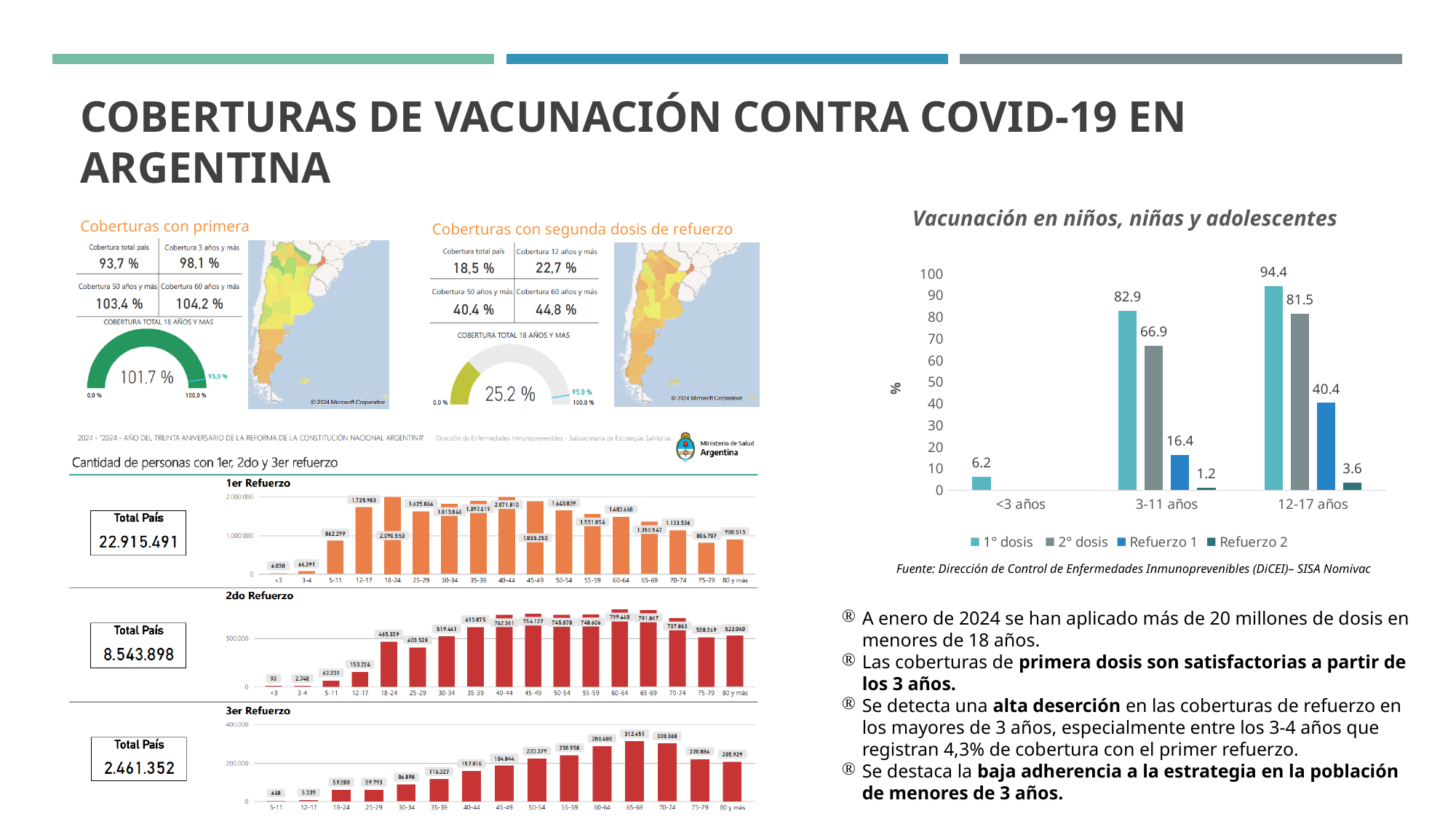
In the 'Vacunación en niños, niñas y adolescentes' chart, which age group has the highest 1° dosis value? 12-17 años In the '3er Refuerzo' chart on the left, what is the Total País value shown? 2.461.352 In the 'Vacunación en niños, niñas y adolescentes' chart, is the Refuerzo 1 value larger for 3-11 años or for 12-17 años? 12-17 años In the 'Vacunación en niños, niñas y adolescentes' chart, what is the value for 2° dosis in the 3-11 años group? 66.9 In the 'Vacunación en niños, niñas y adolescentes' chart, how many series does the legend list? 4 In the 'Vacunación en niños, niñas y adolescentes' chart, what is the label on the y axis? % In the 'Vacunación en niños, niñas y adolescentes' chart, how many age groups are shown on the x axis? 3 In the 'Vacunación en niños, niñas y adolescentes' chart, what is the value for Refuerzo 1 in the 3-11 años group? 16.4 In the 'Vacunación en niños, niñas y adolescentes' chart, what is the value for 1° dosis in the 12-17 años group? 94.4 In the 'Vacunación en niños, niñas y adolescentes' chart, what is the difference between the 1° dosis and 2° dosis values for the 12-17 años group? 12.9 What kind of chart is 'Vacunación en niños, niñas y adolescentes'? Bar chart In the 'Vacunación en niños, niñas y adolescentes' chart, which series has the lowest value in the 12-17 años group? Refuerzo 2